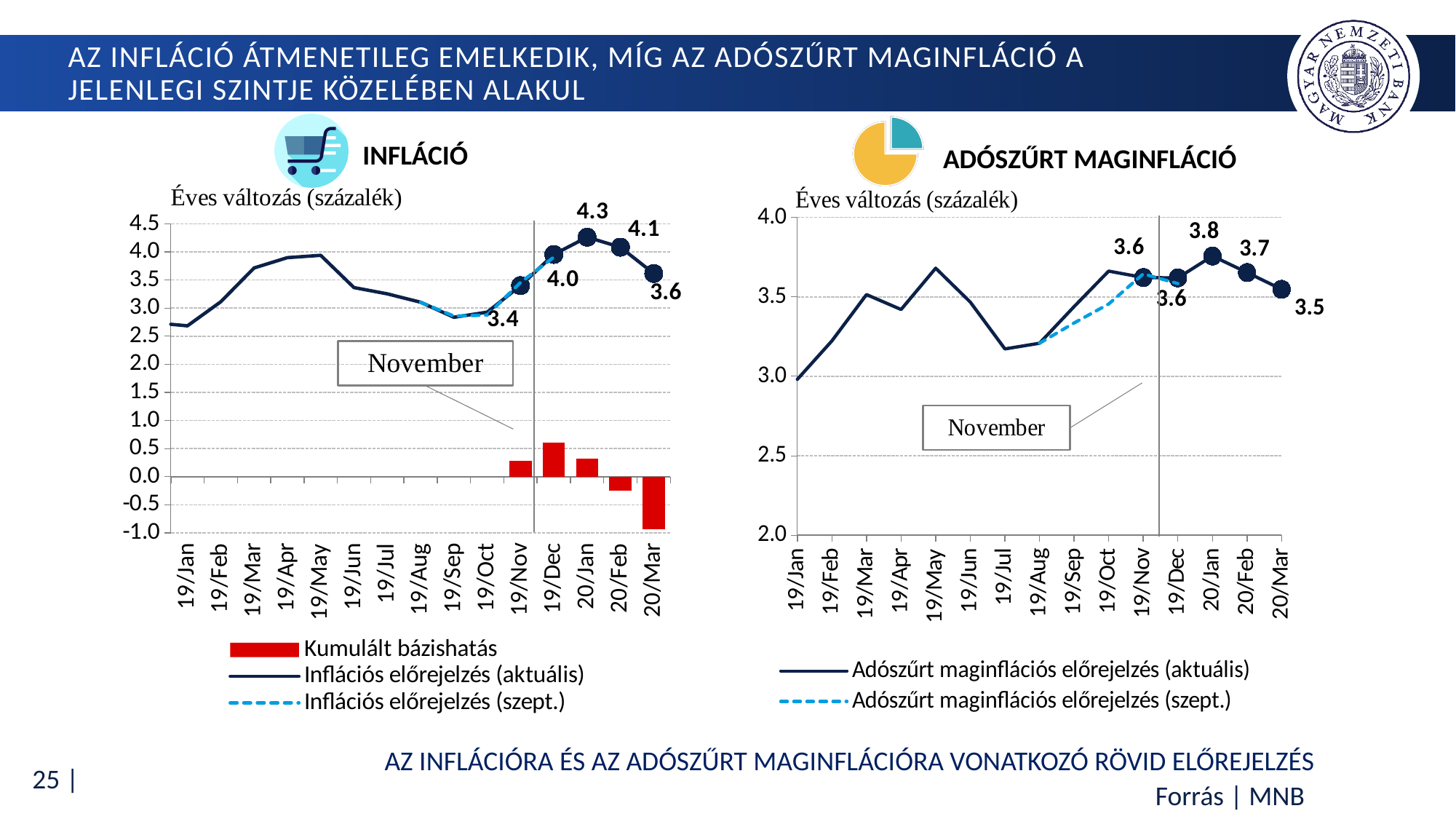
In the ADÓSZŰRT MAGINFLÁCIÓ chart, what is the labelled value for 20/Mar? 3.5 How many entries does the legend of the ADÓSZŰRT MAGINFLÁCIÓ chart list? 2 In the INFLÁCIÓ chart, what is the difference between the labelled values for 20/Jan and 19/Nov? 0.9 In the INFLÁCIÓ chart, what is the labelled value for 20/Mar? 3.6 In the INFLÁCIÓ chart, which labelled month has the highest inflation forecast value? 20/Jan In the ADÓSZŰRT MAGINFLÁCIÓ chart, which is larger, the labelled value for 20/Feb or for 20/Mar? 20/Feb In the INFLÁCIÓ chart, what is the labelled value of the current inflation forecast for 20/Jan? 4.3 How many entries does the legend of the INFLÁCIÓ chart list? 3 In the INFLÁCIÓ chart, what is the labelled value for 19/Nov? 3.4 In the ADÓSZŰRT MAGINFLÁCIÓ chart, is the value for 19/Jul greater or less than 3.5? less In the ADÓSZŰRT MAGINFLÁCIÓ chart, what is the labelled value for 20/Jan? 3.8 In the INFLÁCIÓ chart, is the Kumulált bázishatás bar for 20/Mar greater or less than 0.0? less